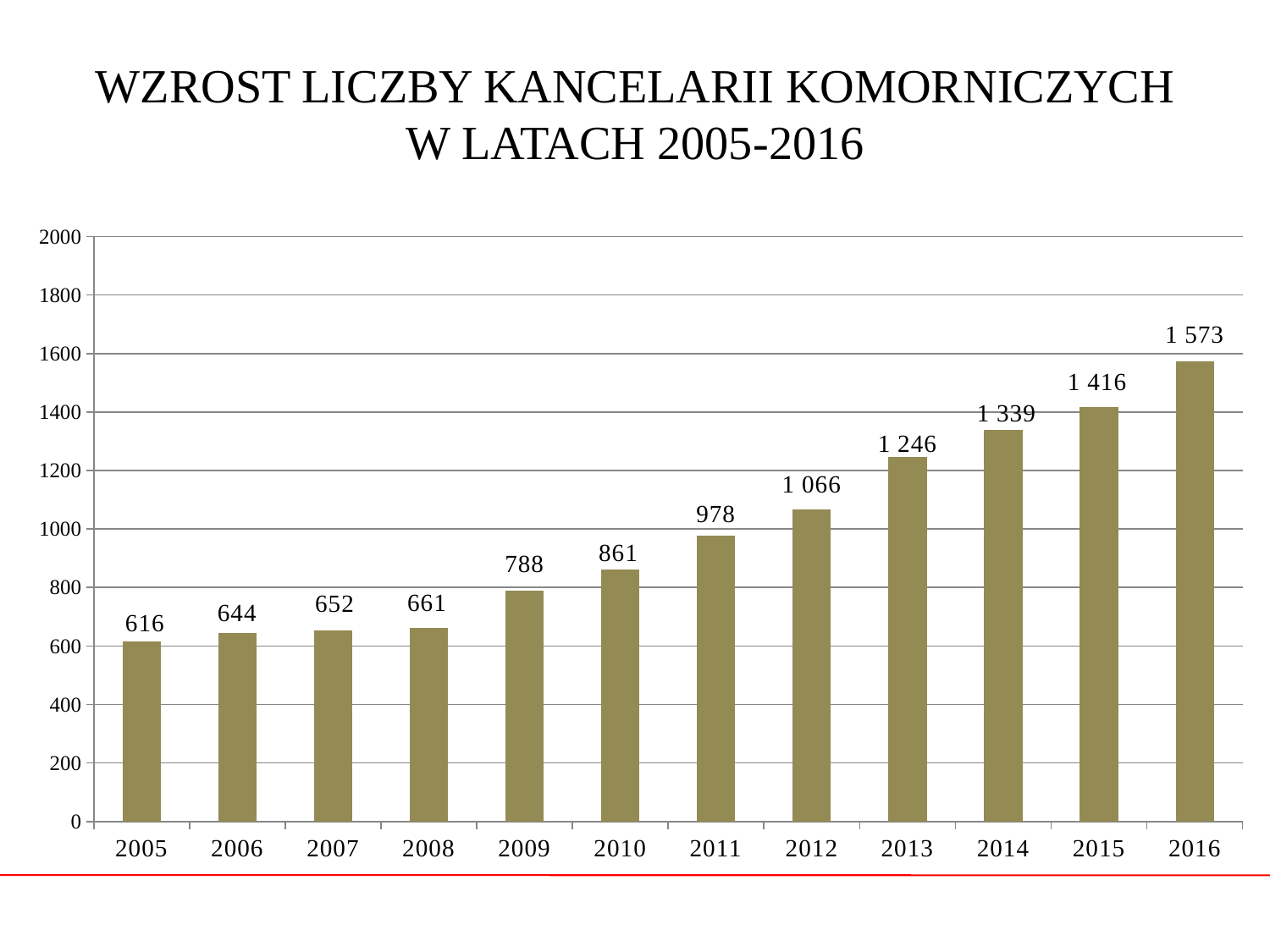
What is the difference between the values for 2010 and 2009? 73 What is the value for 2016? 1 573 What is the value for 2005? 616 How many years are shown on the x axis? 12 Which year has the lowest value? 2005 What is the difference between the values for 2016 and 2005? 957 Is the value for 2014 greater or less than 1200? greater Do the values rise or fall from 2005 to 2016? rise Which year has the highest value? 2016 What kind of chart is this? bar chart Which is larger, the value for 2011 or the value for 2013? 2013 What is the value for 2012? 1 066